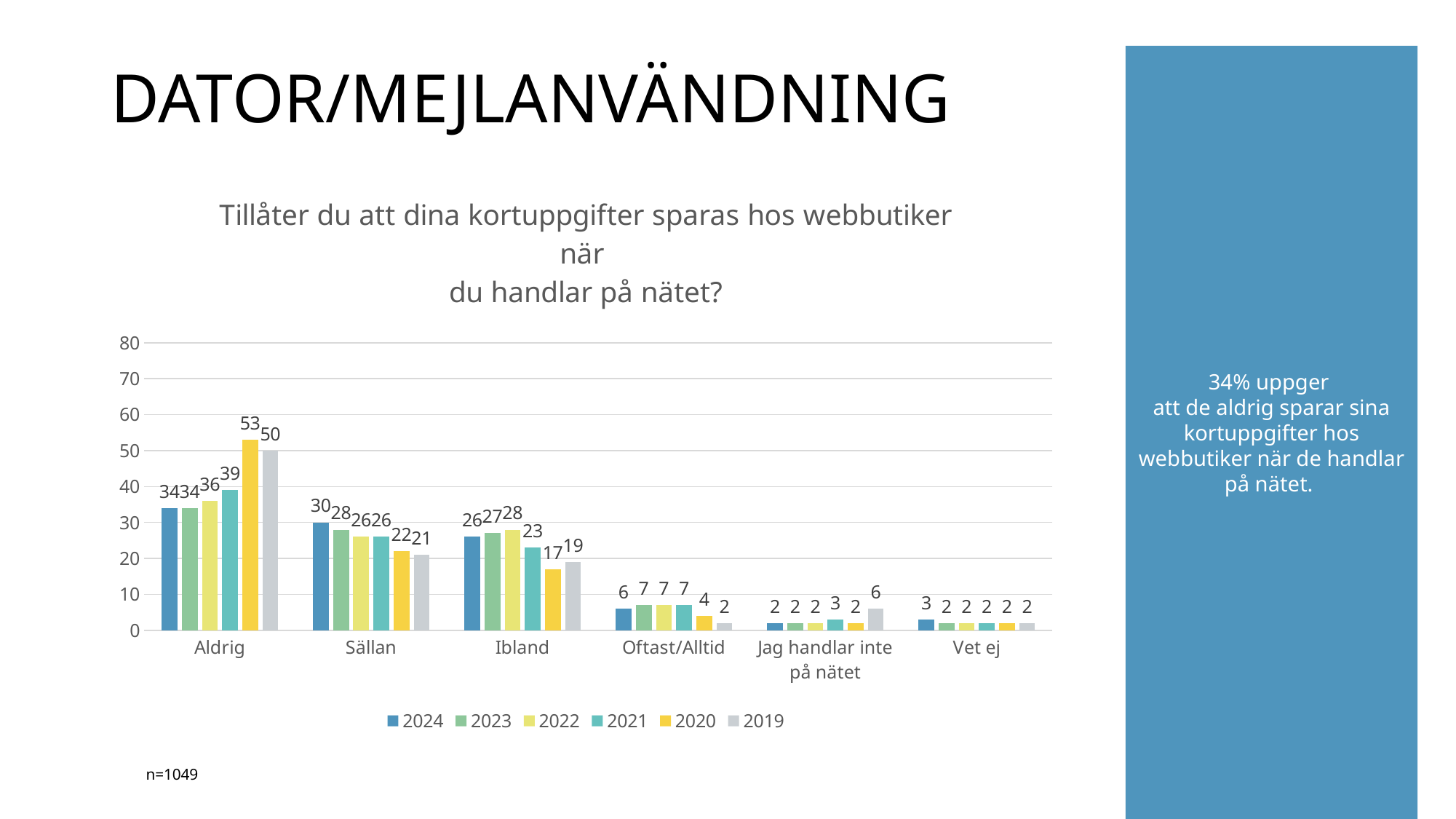
Which is larger in the Ibland category: the value for 2022 or the value for 2020? 2022 What is the sample size (n) stated on the slide? n=1049 What is the value for 2020 in the Aldrig category? 53 What is the value for 2024 in the Aldrig category? 34 Which year has the lowest value in the Sällan category? 2019 How many series does the legend list? 6 What is the difference between the 2020 and 2024 values in the Aldrig category? 19 What kind of chart is shown on the slide? Bar chart How many categories are shown on the x axis? 6 What is the value for 2019 in the Ibland category? 19 What is the value for 2021 in the Sällan category? 26 Which year has the highest value in the Aldrig category? 2020